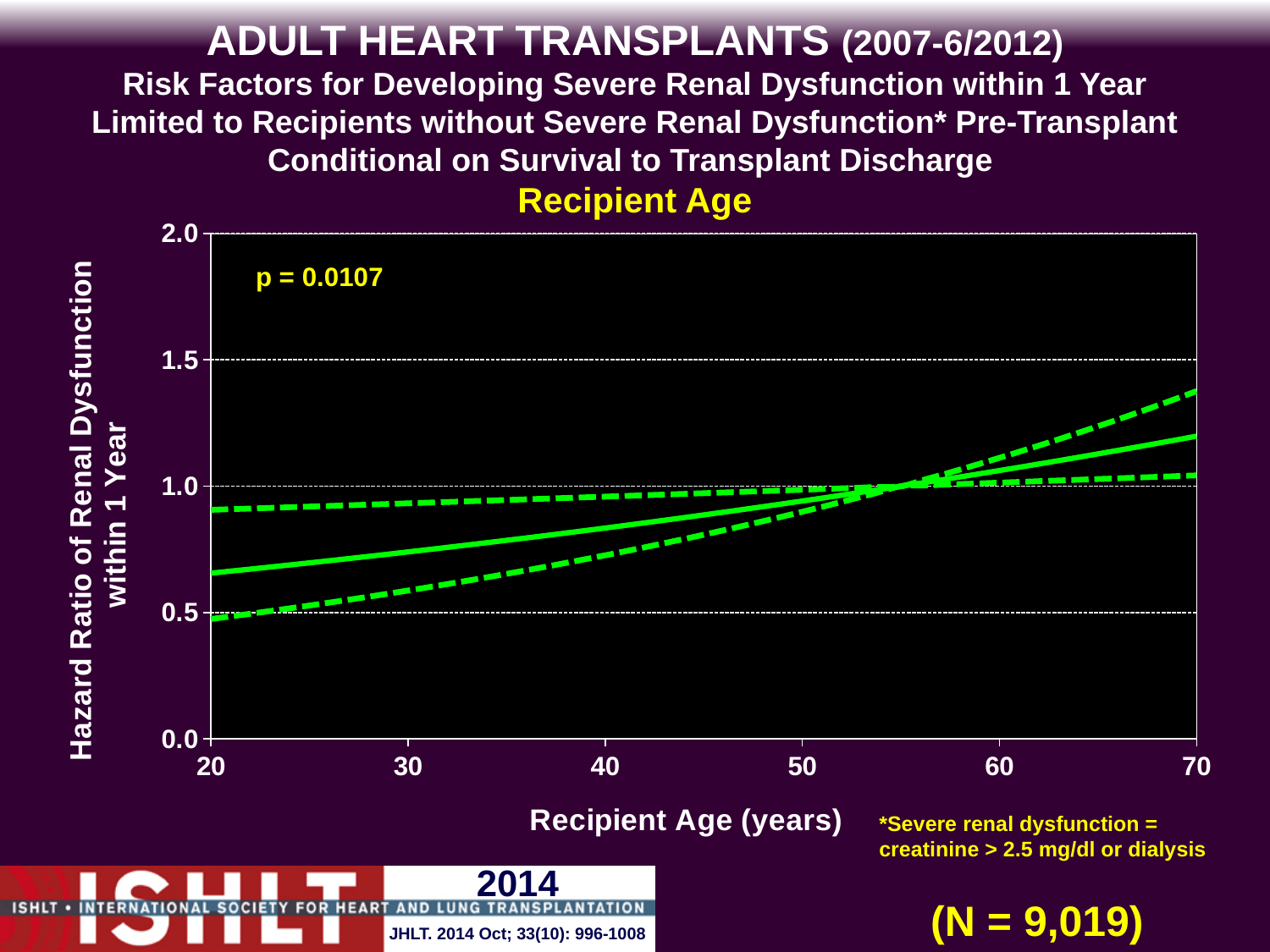
Is the upper dashed line at recipient age 70 greater or less than 1.5? less What is the p-value shown on the chart? p = 0.0107 What is the label of the x axis? Recipient Age (years) What is the maximum value shown on the y axis? 2.0 Does the solid hazard ratio line rise or fall as recipient age increases from 20 to 70 years? rise How many lines are plotted on the chart? 3 What kind of chart is shown on the slide? line chart Is the hazard ratio (solid line) at recipient age 70 greater or less than 1.0? greater Is the hazard ratio (solid line) higher at recipient age 70 or at recipient age 20? 70 Is the hazard ratio (solid line) at recipient age 20 greater or less than 1.0? less